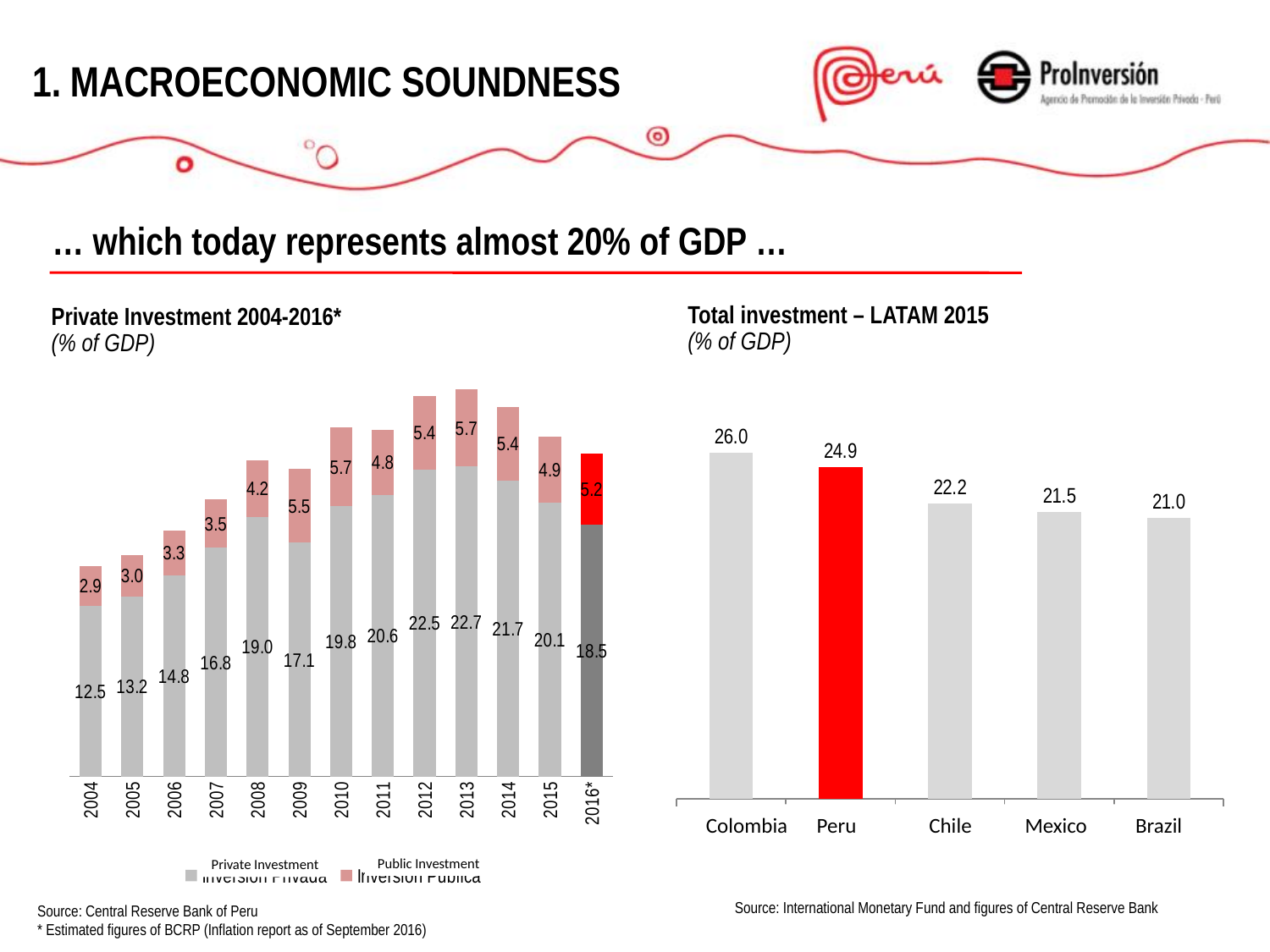
In the 'Total investment – LATAM 2015' chart, what is the value for Peru? 24.9 In the 'Private Investment 2004-2016*' chart, which year has the lowest private investment value? 2004 In the 'Private Investment 2004-2016*' chart, what is the total of the stacked bar for 2016*? 23.7 In the 'Total investment – LATAM 2015' chart, which country has the highest value? Colombia In the 'Total investment – LATAM 2015' chart, what is the difference between Colombia and Peru? 1.1 In the 'Private Investment 2004-2016*' chart, what is the public investment value for 2009? 5.5 In the 'Total investment – LATAM 2015' chart, how many countries are shown? 5 In the 'Private Investment 2004-2016*' chart, is the private investment value for 2008 larger or the value for 2009? 2008 In the 'Private Investment 2004-2016*' chart, what is the private investment value for 2013? 22.7 In the 'Total investment – LATAM 2015' chart, which country has the lowest value? Brazil What kind of chart is the 'Total investment – LATAM 2015' chart? Bar chart In the 'Private Investment 2004-2016*' chart, how many series does the legend list? 2